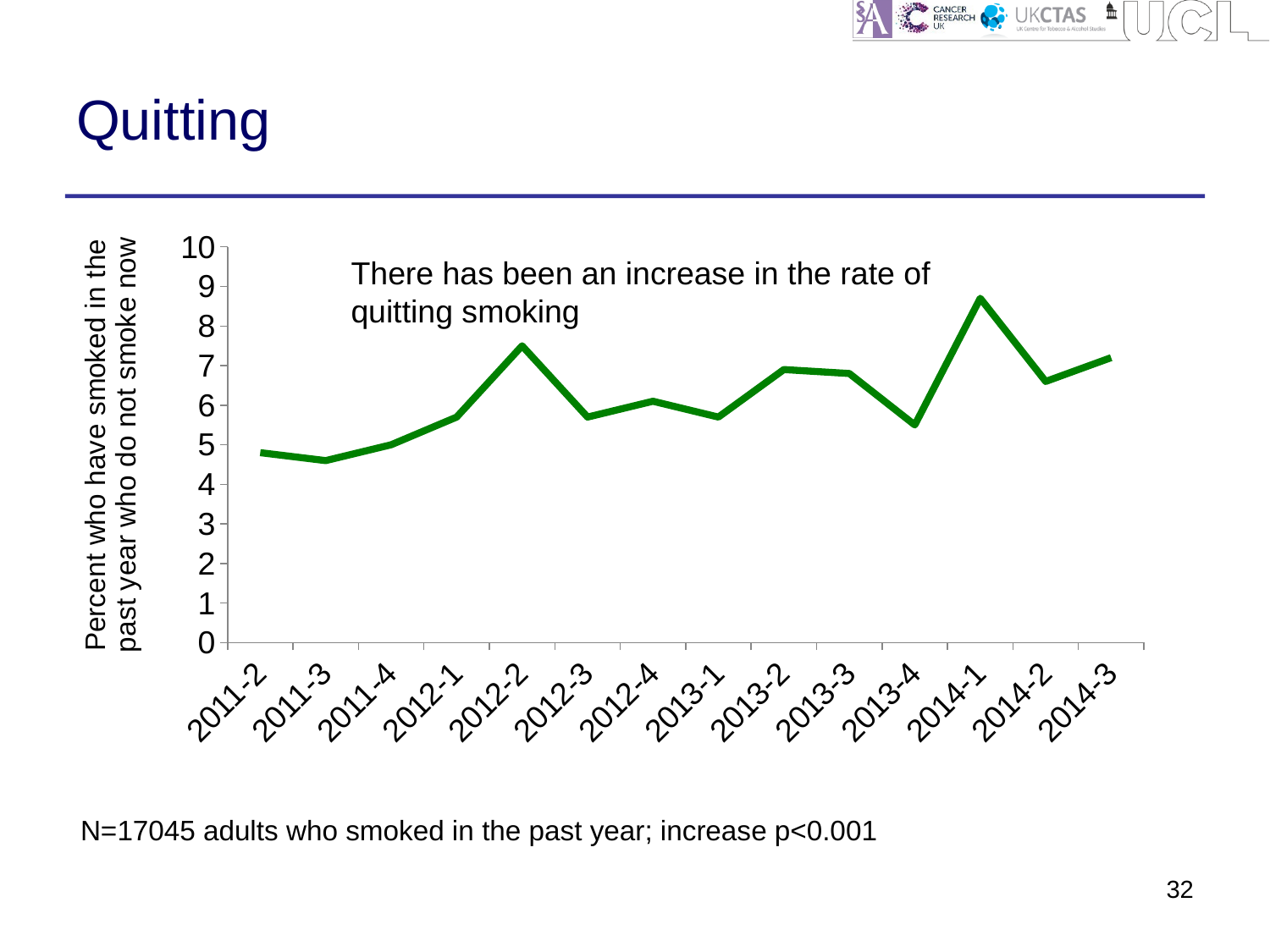
Is the value for 2013-4 greater or less than 6? less Overall, does the quitting rate rise or fall from 2011-2 to 2014-3? rise What is the first x-axis category on the chart? 2011-2 Which quarter has the highest percentage of past-year smokers who do not smoke now? 2014-1 What kind of chart is shown on the slide? line chart Which is larger, the value for 2013-4 or the value for 2014-2? 2014-2 How many quarterly points are plotted on the line? 14 Which is larger, the value for 2012-2 or the value for 2013-2? 2012-2 Is the value for 2011-3 greater or less than 5? less Is the value for 2014-1 greater or less than 8? greater What is the label on the vertical axis of the chart? Percent who have smoked in the past year who do not smoke now